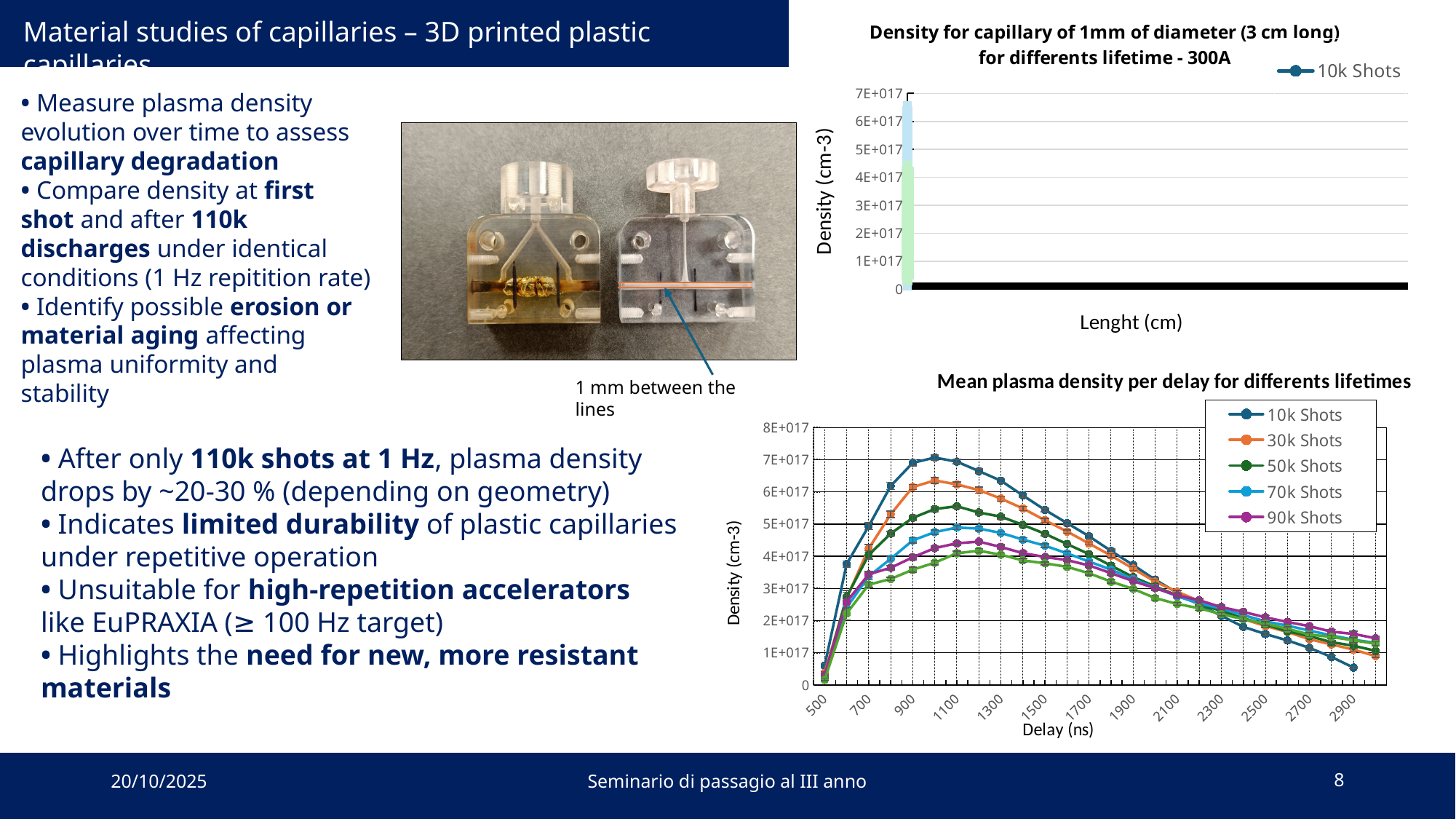
What is the only legend entry shown on the top chart titled 'Density for capillary of 1mm of diameter (3 cm long) for differents lifetime - 300A'? 10k Shots In the 'Mean plasma density per delay for differents lifetimes' chart, is the 10k Shots value at 2900 ns greater or less than 1E+017? less How many series does the legend of the 'Mean plasma density per delay for differents lifetimes' chart list? 5 What is the x-axis label of the 'Mean plasma density per delay for differents lifetimes' chart? Delay (ns) In the 'Mean plasma density per delay for differents lifetimes' chart, which series has the lowest density at a delay of 2900 ns? 10k Shots In the 'Mean plasma density per delay for differents lifetimes' chart, which series reaches the highest peak density? 10k Shots In the 'Mean plasma density per delay for differents lifetimes' chart, do the densities rise or fall as the delay increases from 1300 ns to 2900 ns? fall How many tick labels are shown on the x axis of the 'Mean plasma density per delay for differents lifetimes' chart? 13 In the 'Mean plasma density per delay for differents lifetimes' chart, is the peak value of the 90k Shots series greater or less than 5E+017? less In the 'Mean plasma density per delay for differents lifetimes' chart, is the peak value of the 10k Shots series greater or less than 6E+017? greater What kind of chart is the 'Mean plasma density per delay for differents lifetimes' chart? line chart In the 'Mean plasma density per delay for differents lifetimes' chart, at a delay of 900 ns, which series has the larger density: 10k Shots or 90k Shots? 10k Shots